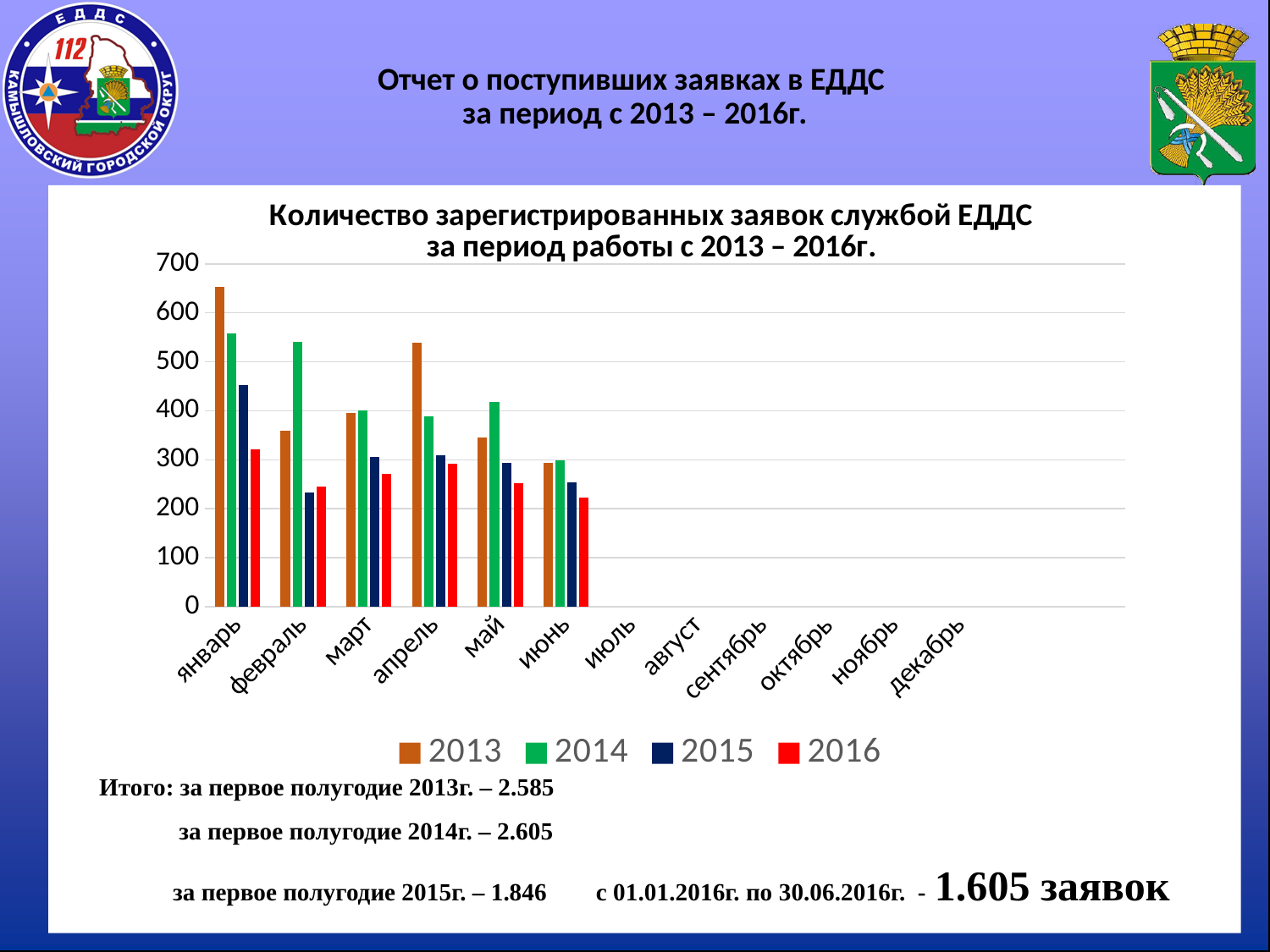
In февраль, which series is larger: 2013 or 2014? 2014 In январь, which series is larger: 2013 or 2014? 2013 Which month has the lowest value for the 2016 series? июнь Is the value for 2013 in январь greater or less than 600? greater How many months are labelled on the x axis? 12 Do the values for the 2016 series rise or fall from апрель to июнь? fall How many series does the legend list? 4 Which colour represents the 2014 series in the legend? green Is the value for 2015 in февраль greater or less than 300? less Which month has the highest value for the 2013 series? январь For how many months are bars actually plotted? 6 What kind of chart is shown on the slide? bar chart